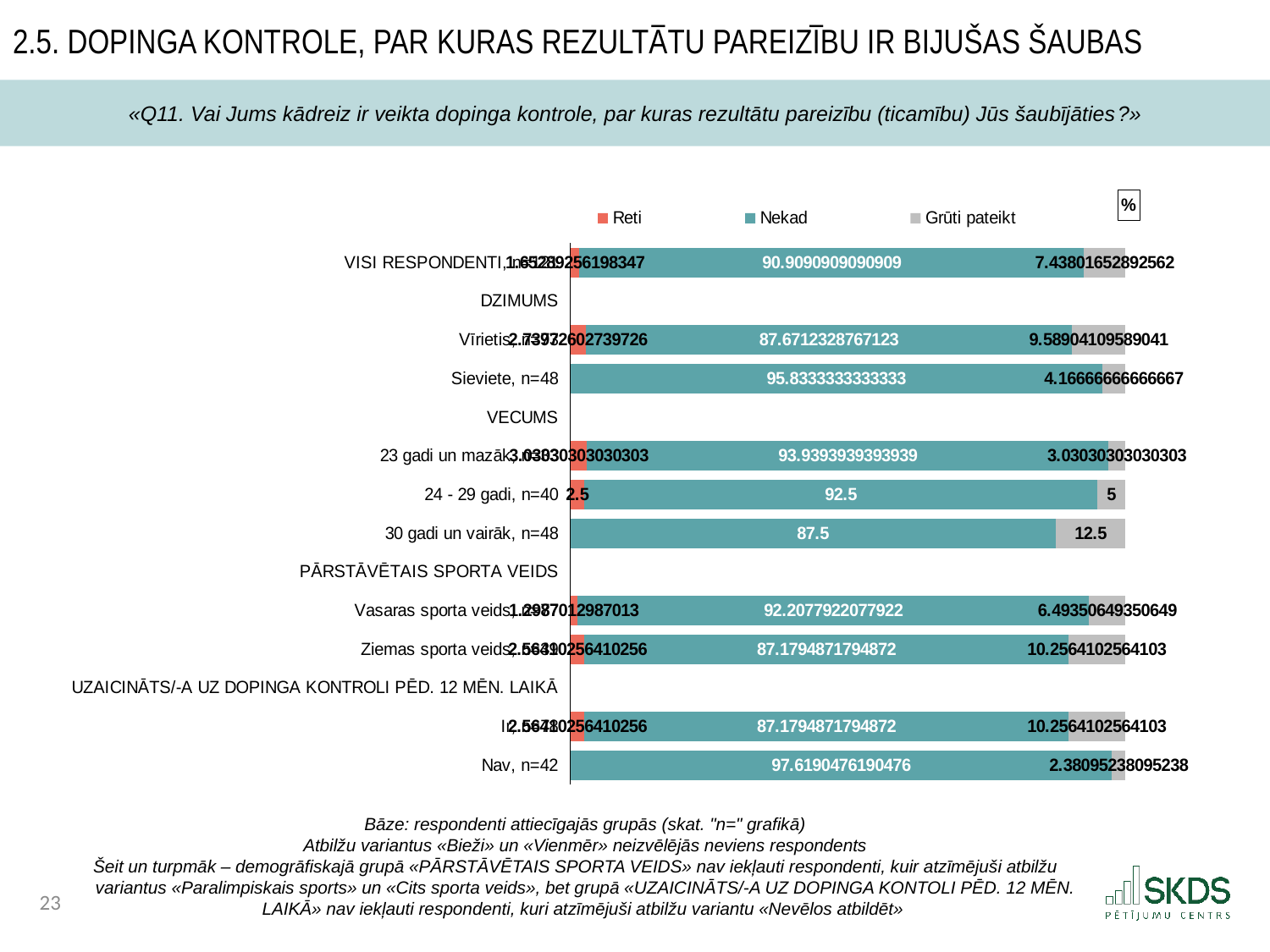
What is the value of "Grūti pateikt" for the group "30 gadi un vairāk, n=48"? 12.5 What is the difference between the "Nekad" values for "24 - 29 gadi, n=40" and "30 gadi un vairāk, n=48"? 5 What is the value of "Nekad" for the group "Sieviete, n=48"? 95.8333333333333 How many series does the chart legend list? 3 Which group has the larger "Nekad" value, "Sieviete, n=48" or "Vīrietis"? Sieviete, n=48 What is the value of "Nekad" for the group "Nav, n=42"? 97.6190476190476 What are the three series named in the chart legend? Reti, Nekad, Grūti pateikt What kind of chart is shown on the slide? bar chart Which group has the highest value for "Grūti pateikt"? 30 gadi un vairāk, n=48 Which group has the highest value for "Nekad"? Nav, n=42 What is the value of "Reti" for the group "24 - 29 gadi, n=40"? 2.5 What is the value of "Nekad" for the group "24 - 29 gadi, n=40"? 92.5